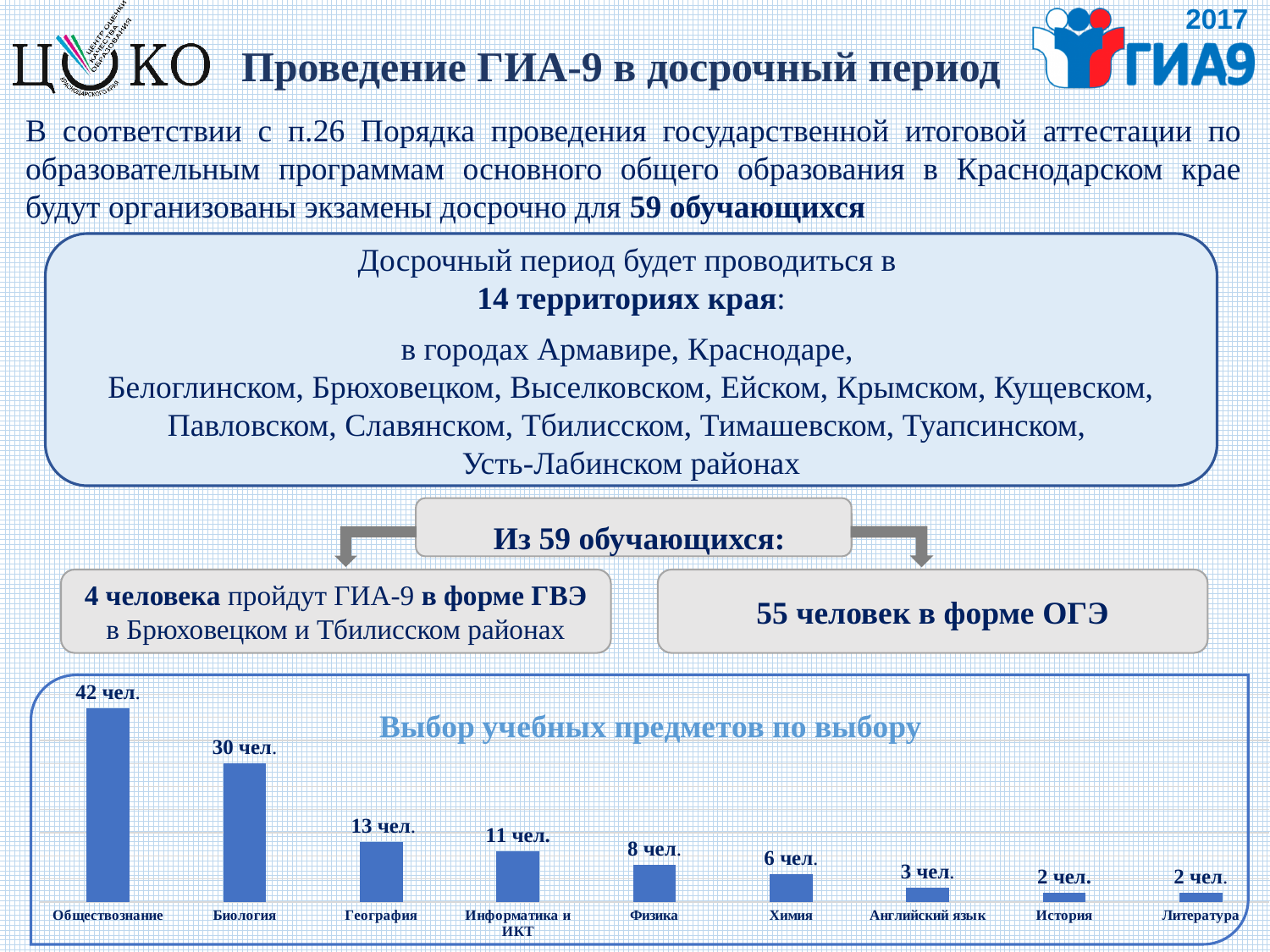
What is the value for Химия in the chart? 6 чел. How many subjects (categories) are shown in the chart? 9 Do the values rise or fall from left to right across the chart? Fall What is the value shown for Информатика и ИКТ? 11 чел. What is the difference between the values for Обществознание and Биология? 12 чел. How many people chose Биология according to the chart? 30 чел. Which subject has the highest value in the chart? Обществознание What is the value for Обществознание in the chart? 42 чел. What is the title of the chart? Выбор учебных предметов по выбору Which has a larger value, Физика or Химия? Физика What kind of chart is shown at the bottom of the slide? Bar chart What is the value shown for География? 13 чел.